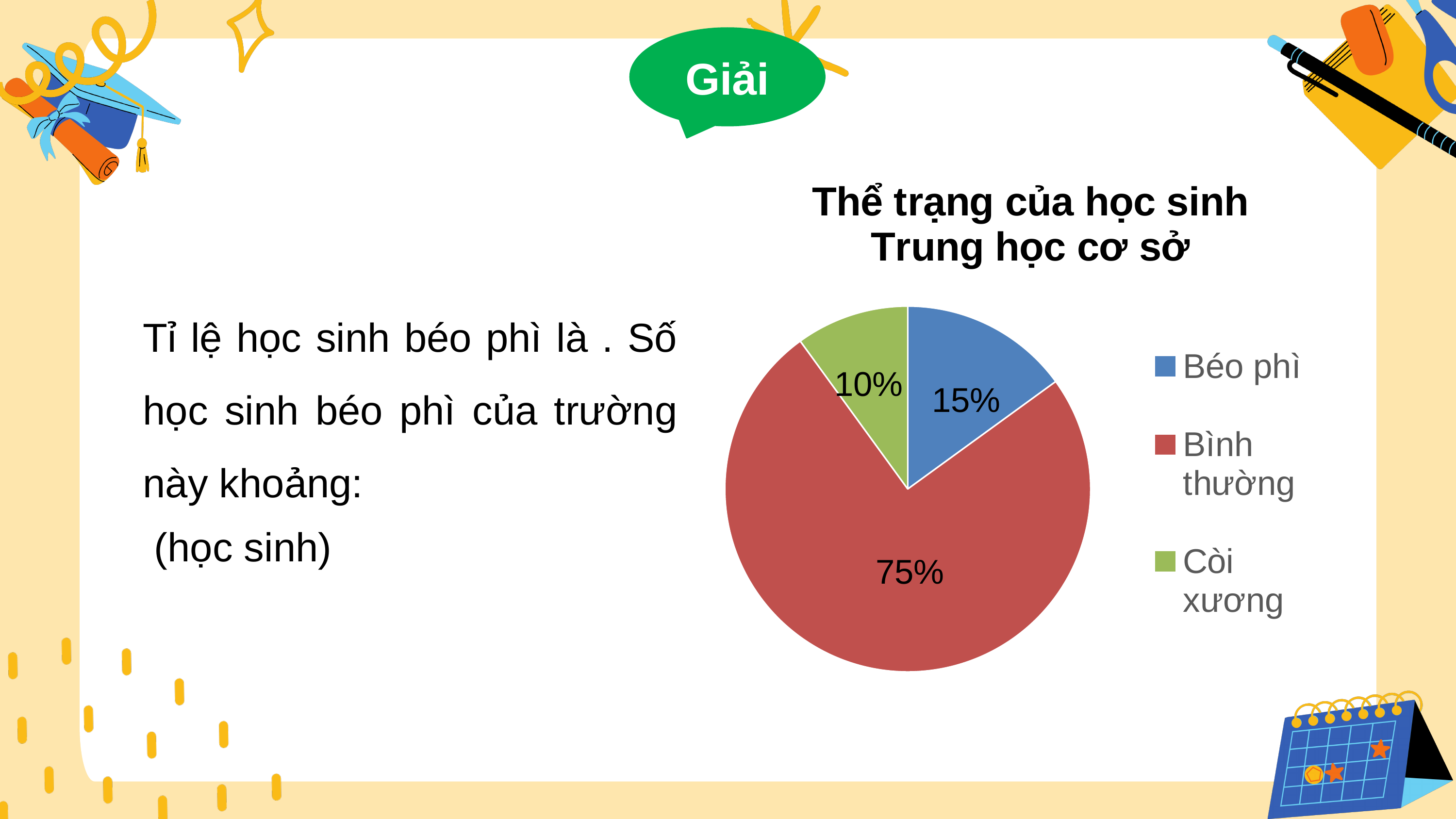
What is the title of the chart? Thể trạng của học sinh Trung học cơ sở What percentage of the pie chart is labelled for Béo phì? 15% What percentage of the pie chart is labelled for Còi xương? 10% What is the difference in percentage points between Bình thường and Béo phì? 60 What colour is the slice for Bình thường? Red How many categories are shown in the pie chart? 3 Which category has the largest slice of the pie chart? Bình thường Which category has the smallest slice of the pie chart? Còi xương What kind of chart is shown on the slide? Pie chart Which is larger, the slice for Béo phì or the slice for Còi xương? Béo phì What is the difference in percentage points between Béo phì and Còi xương? 5 What percentage of the pie chart is labelled for Bình thường? 75%